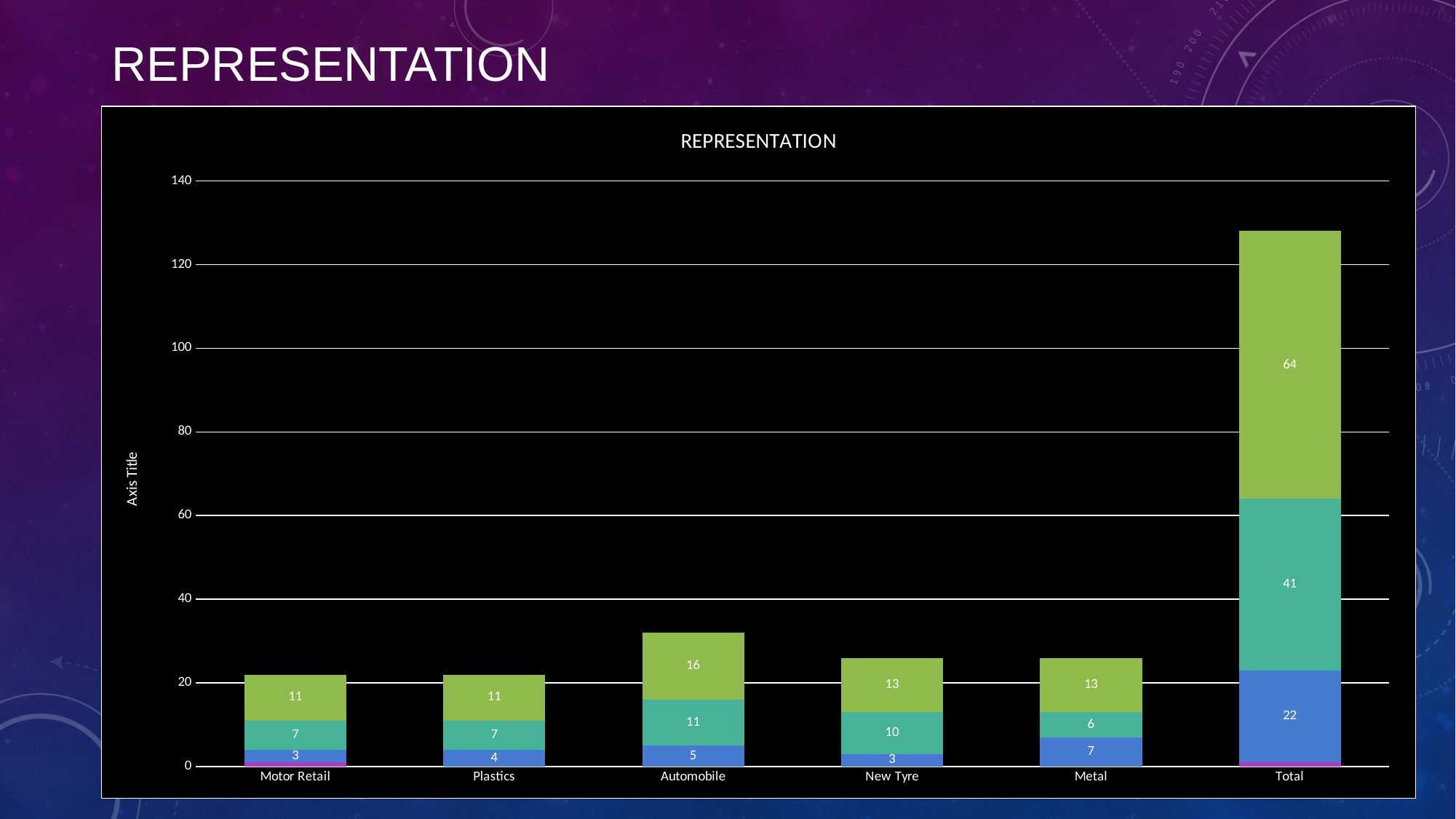
What is the value of the green (top) segment for Automobile? 16 What is the title of the chart? REPRESENTATION What is the sum of the labelled segments in the Automobile bar? 32 What kind of chart is shown on the slide? Stacked bar chart Is the total height of the Total bar greater or less than 120? greater Which has the larger green segment, Automobile or New Tyre? Automobile Is the total height of the Automobile bar greater or less than 40? less How many categories are shown along the x axis? 6 What is the difference between the green segment (64) and the teal segment (41) of the Total bar? 23 Which category has the tallest stacked bar? Total What is the value of the blue (bottom) segment for Metal? 7 What is the value of the teal (middle) segment for Total? 41